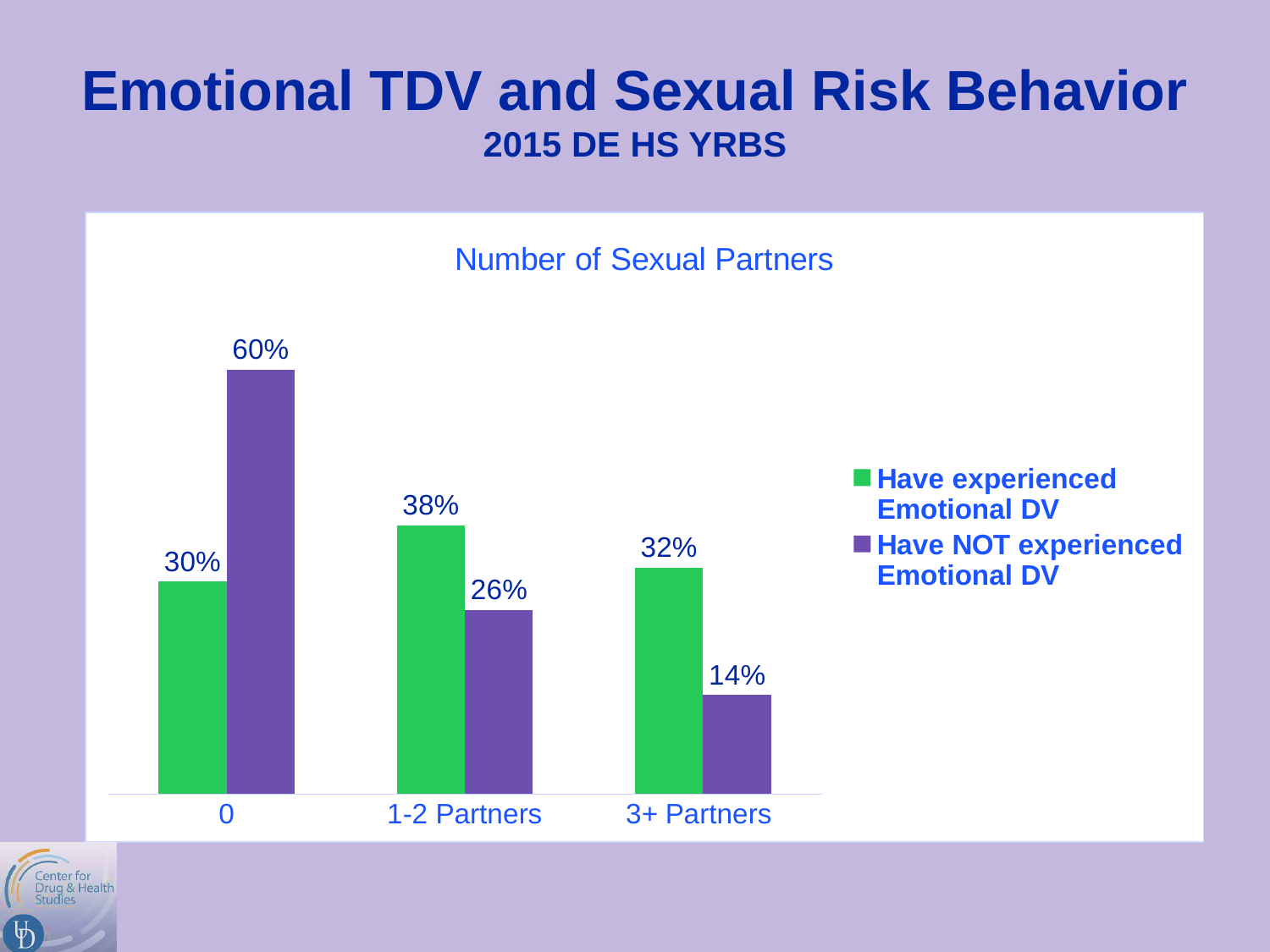
Which category has the highest value for the 'Have NOT experienced Emotional DV' series? 0 What is the difference between the two series for the 0 partners category? 30% Which category has the lowest value for the 'Have experienced Emotional DV' series? 0 What is the difference between the two series for the 3+ Partners category? 18% How many categories are shown on the x axis? 3 What is the value for 1-2 Partners among those who have experienced Emotional DV? 38% For 1-2 Partners, which group has the larger value: those who have experienced Emotional DV or those who have NOT? Have experienced Emotional DV What is the value for 3+ Partners among those who have NOT experienced Emotional DV? 14% How many series does the legend list? 2 What percentage of those who have experienced Emotional DV reported 0 sexual partners? 30% What percentage of those who have NOT experienced Emotional DV reported 0 sexual partners? 60% What kind of chart is shown on the slide? Bar chart